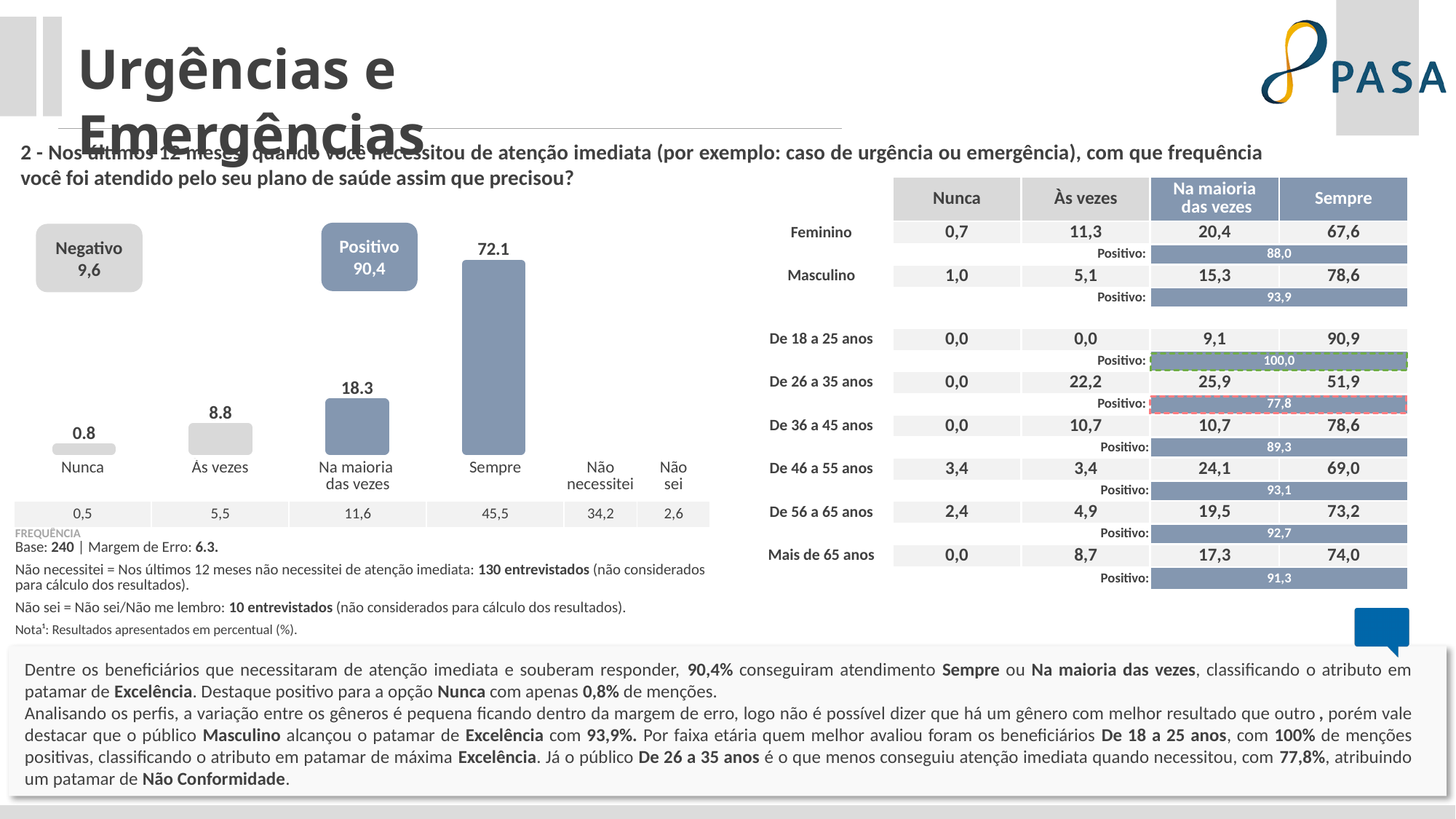
Do the bar values rise or fall from 'Nunca' to 'Sempre' along the x axis? Rise What is the value of the 'Nunca' bar in the chart? 0.8 Which is larger in the chart, 'Às vezes' or 'Na maioria das vezes'? Na maioria das vezes Which category has the highest bar in the chart? Sempre What value is shown in the 'Positivo' box above the chart? 90,4 Which category has the lowest bar in the chart? Nunca What is the value of the 'Às vezes' bar in the chart? 8.8 What is the value of the 'Na maioria das vezes' bar in the chart? 18.3 What kind of chart is shown on the left of the slide? Bar chart What is the difference between the 'Sempre' and 'Na maioria das vezes' bars? 53.8 What is the value of the 'Sempre' bar in the chart? 72.1 What is the difference between the 'Na maioria das vezes' and 'Às vezes' bars? 9.5